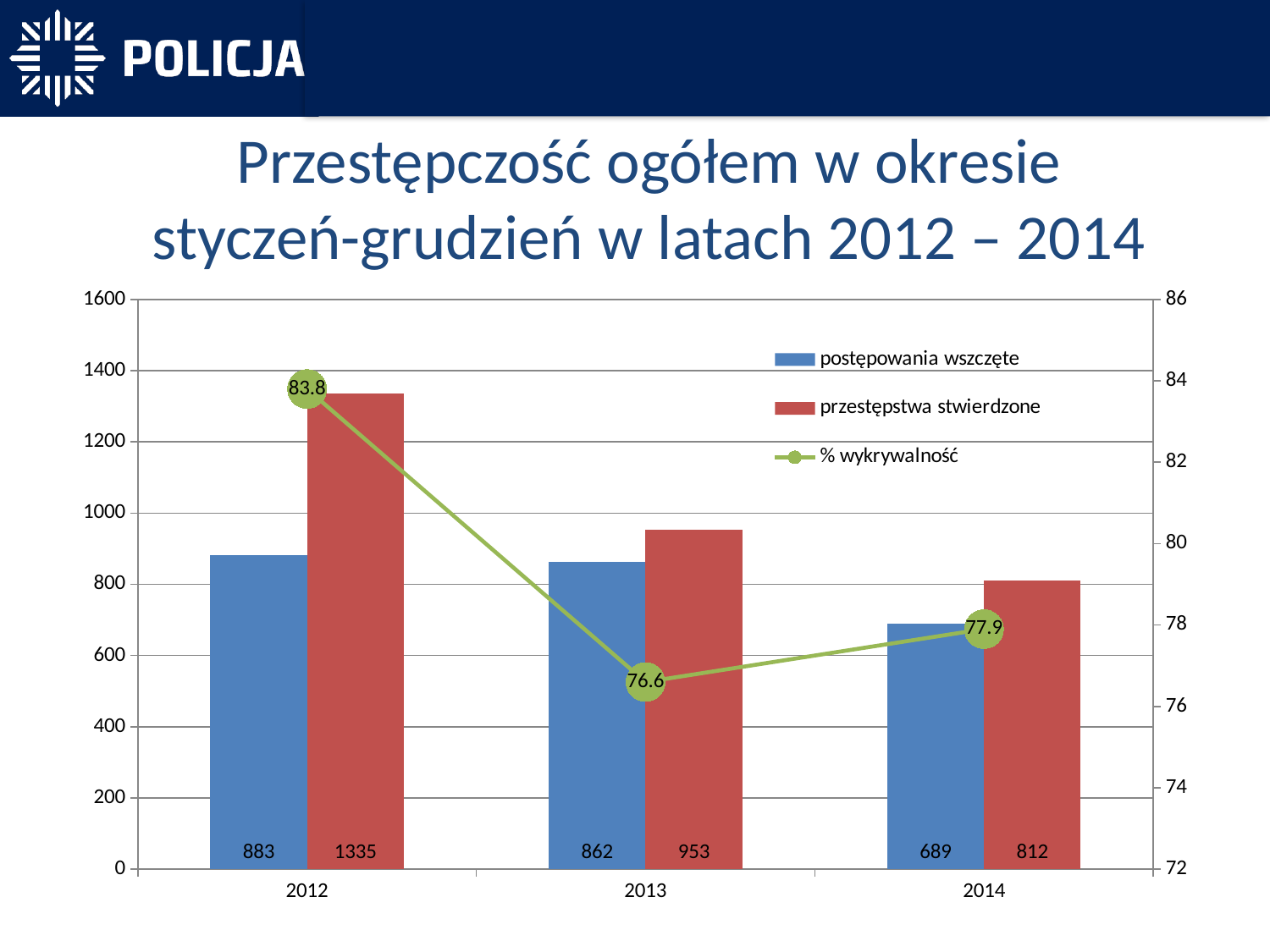
What is the difference between przestępstwa stwierdzone and postępowania wszczęte in 2014? 123 Which is larger in 2013: postępowania wszczęte or przestępstwa stwierdzone? przestępstwa stwierdzone Which year has the lowest % wykrywalność? 2013 Do the values of postępowania wszczęte rise or fall from 2012 to 2014? Fall Which series is shown in red? przestępstwa stwierdzone How many years are shown on the x axis? 3 What kind of chart is shown on the slide? Combined bar and line chart What is the value of postępowania wszczęte for 2012? 883 Which year has the highest value of przestępstwa stwierdzone? 2012 What is the value of przestępstwa stwierdzone for 2013? 953 How many series does the legend list? 3 What is the % wykrywalność value for 2014? 77.9